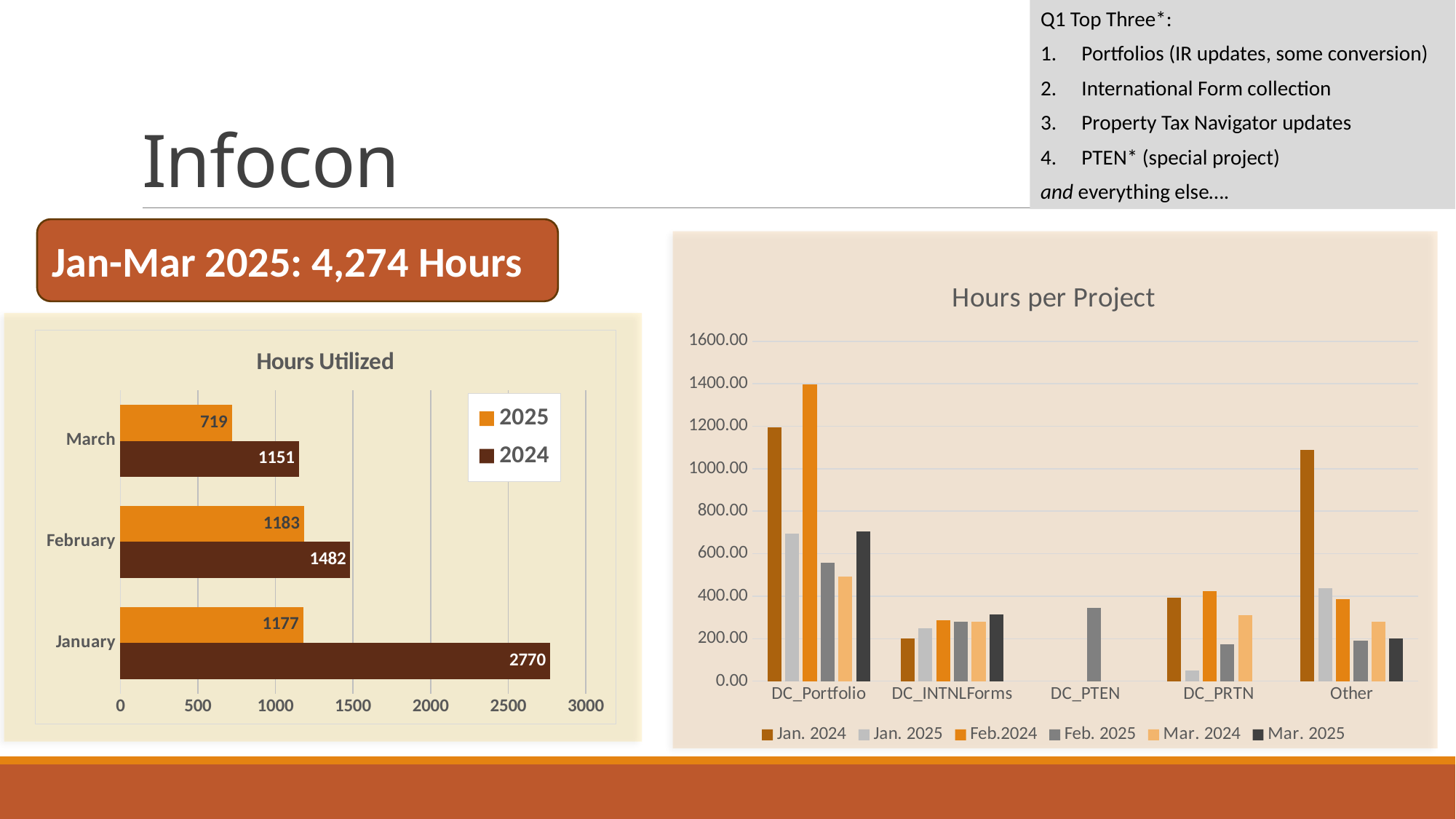
In the Hours per Project chart, which category has the highest Jan. 2024 value? DC_Portfolio In the Hours Utilized chart, which is larger: the 2025 value for January or the 2025 value for February? February In the Hours Utilized chart, how many series does the legend list? 2 In the Hours Utilized chart, how many hours were utilized in March 2025? 719 In the Hours per Project chart, is the Feb.2024 value for DC_Portfolio greater or less than 1200? greater In the Hours Utilized chart, how many hours were utilized in January 2024? 2770 In the Hours per Project chart, how many series does the legend list? 6 In the Hours per Project chart, how many project categories are shown on the x axis? 5 What kind of chart is the Hours Utilized chart? Bar chart In the Hours Utilized chart, which month has the lowest 2025 value? March In the Hours Utilized chart, which month has the highest 2024 value? January In the Hours Utilized chart, what is the difference between the 2024 and 2025 values for February? 299